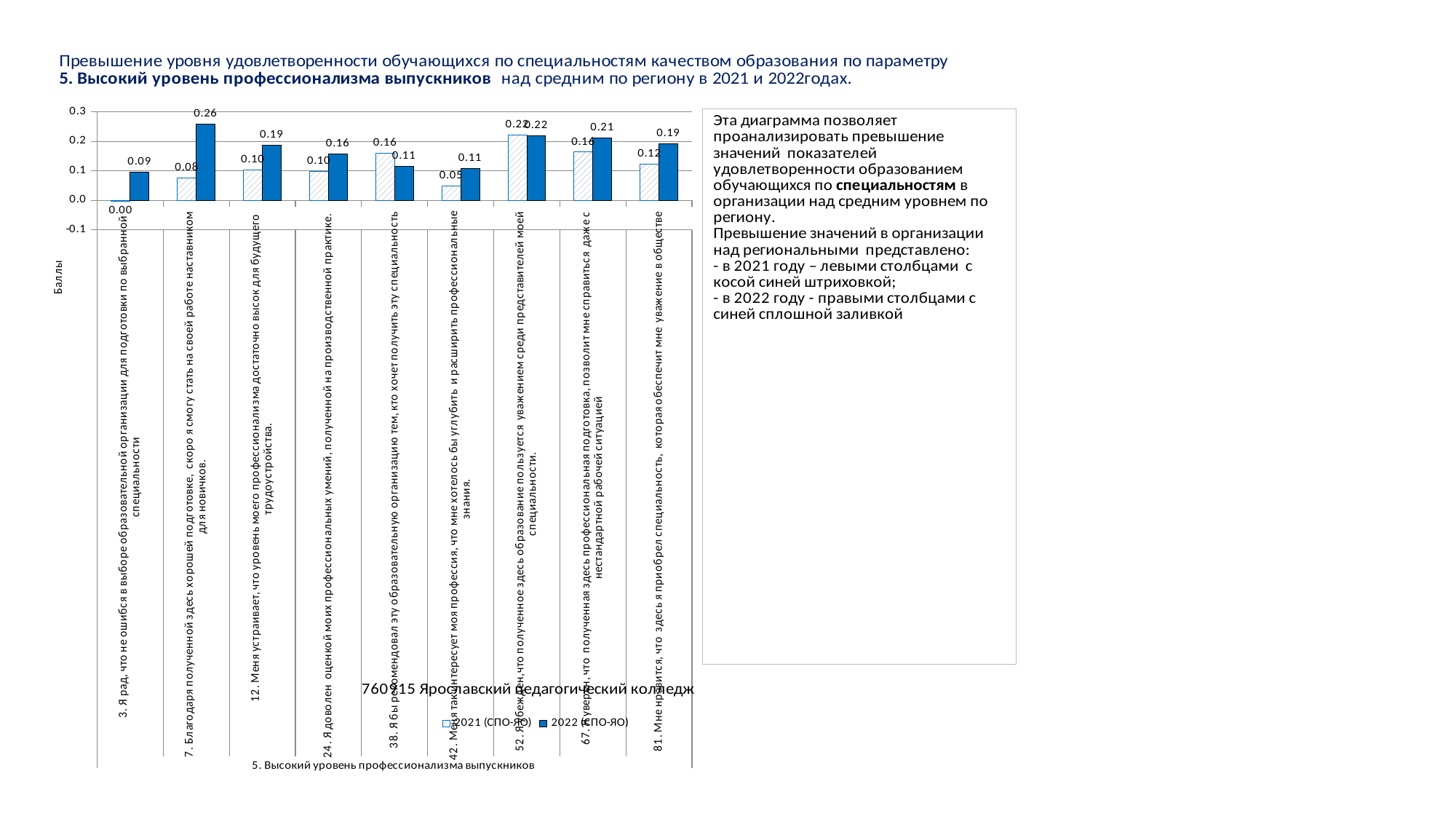
How many series does the chart legend list? 2 Which series is shown with solid blue fill according to the legend? 2022 (СПО-ЯО) Which statement has the highest 2022 (СПО-ЯО) value? 7. Благодаря полученной здесь хорошей подготовке, скоро я смогу стать на своей работе наставником для новичков. What is the 2021 (СПО-ЯО) value for statement 3 (Я рад, что не ошибся в выборе образовательной организации...)? 0.00 What is the difference between the 2022 and 2021 values for statement 7? 0.18 For statement 38 (Я бы рекомендовал эту образовательную организацию...), which is larger: the 2021 value or the 2022 value? 2021 What type of chart is shown on the slide? bar chart What is the 2021 (СПО-ЯО) value for statement 42 (Меня так интересует моя профессия...)? 0.05 How many categories (statements) are plotted on the x axis of the chart? 9 What is the 2022 (СПО-ЯО) value for statement 7 (Благодаря полученной здесь хорошей подготовке...)? 0.26 What is the 2022 (СПО-ЯО) value for statement 81 (Мне нравится, что здесь я приобрел специальность...)? 0.19 Which statement has the lowest 2021 (СПО-ЯО) value? 3. Я рад, что не ошибся в выборе образовательной организации для подготовки по выбранной специальности